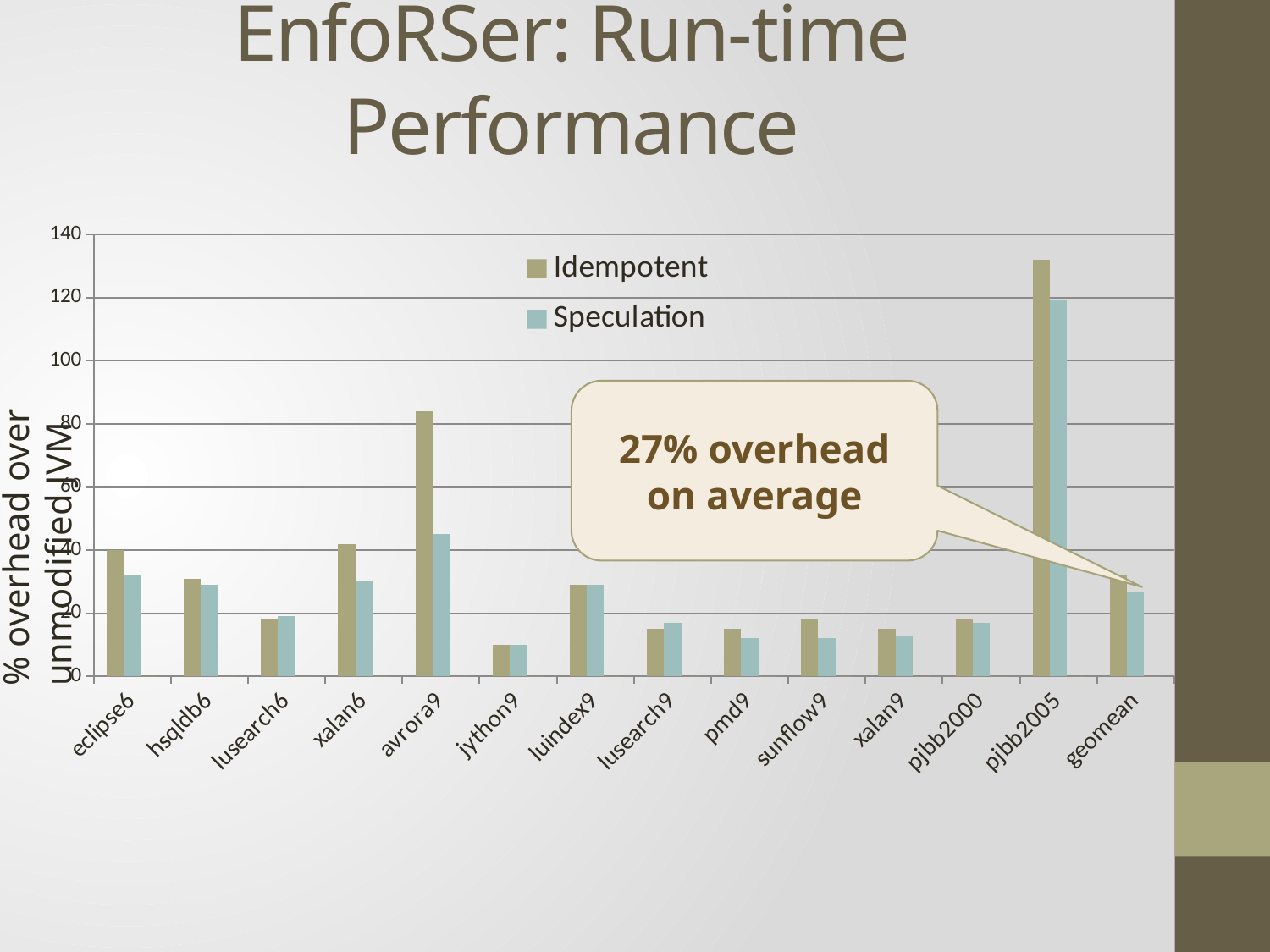
What kind of chart is shown on the slide? bar chart Is the Speculation value for avrora9 greater or less than 60? less For xalan6, which series has the larger value, Idempotent or Speculation? Idempotent How many series does the legend list? 2 Which category has the highest Idempotent value? pjbb2005 Which category has the lowest Idempotent value? jython9 What average overhead does the callout on the chart state? 27% overhead on average Which category has the highest Speculation value? pjbb2005 Is the Idempotent value for pjbb2005 greater or less than 120? greater For avrora9, which series has the larger value, Idempotent or Speculation? Idempotent How many benchmark categories are shown along the x axis? 14 Is the Idempotent value for avrora9 greater or less than 60? greater